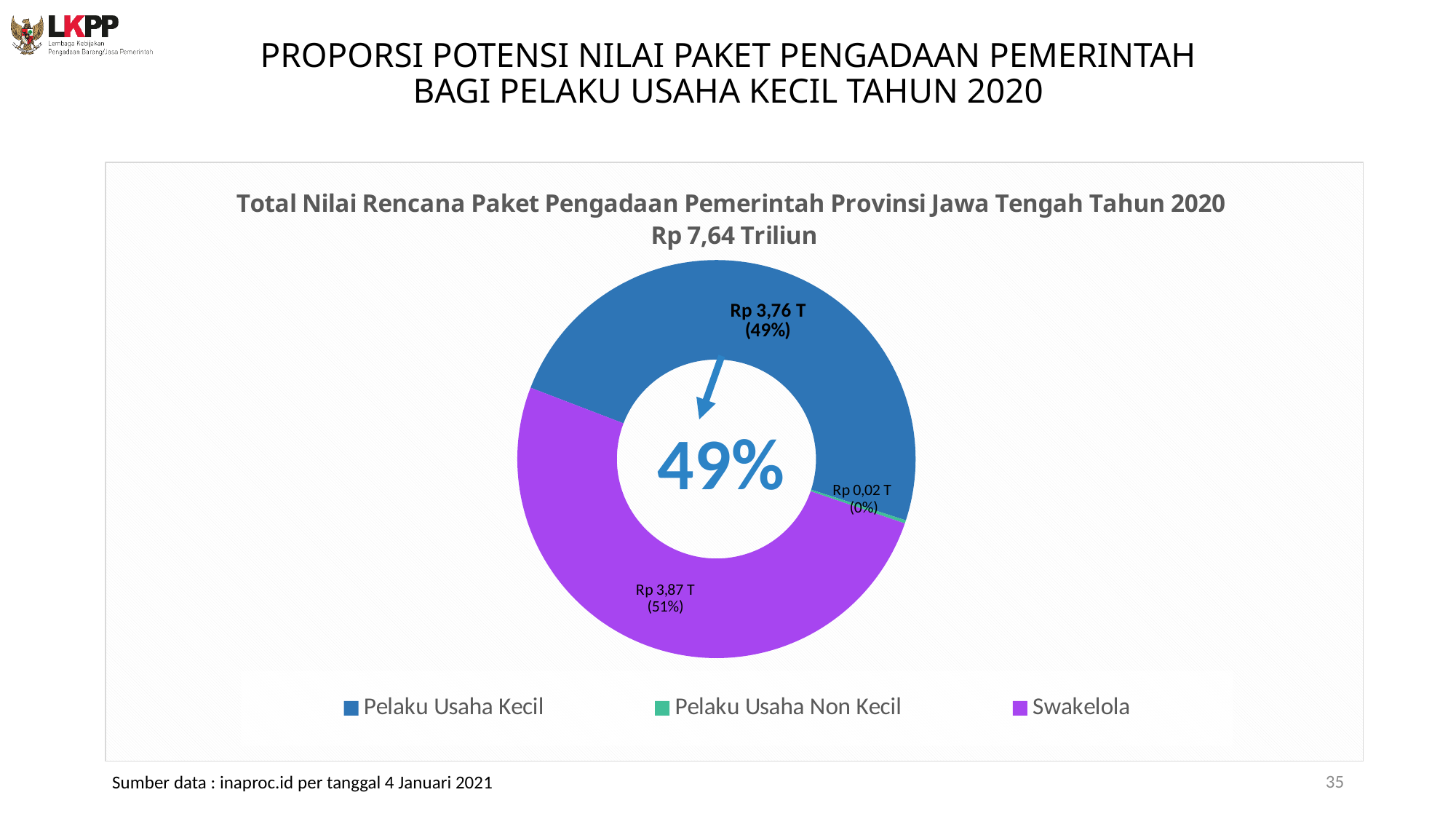
What share of the chart does Pelaku Usaha Kecil represent? 49% What share of the chart does Swakelola represent? 51% Which category has the largest value in the chart? Swakelola Which is larger, the value for Swakelola or the value for Pelaku Usaha Kecil? Swakelola What value is shown for Pelaku Usaha Kecil in the doughnut chart? Rp 3,76 T Which category has the smallest value in the chart? Pelaku Usaha Non Kecil What type of chart is shown on the slide? Doughnut (pie) chart What value is shown for Pelaku Usaha Non Kecil in the doughnut chart? Rp 0,02 T What share of the chart does Pelaku Usaha Non Kecil represent? 0% How many categories does the chart legend list? 3 What is the difference between the values for Swakelola and Pelaku Usaha Kecil? Rp 0,11 T What value is shown for Swakelola in the doughnut chart? Rp 3,87 T